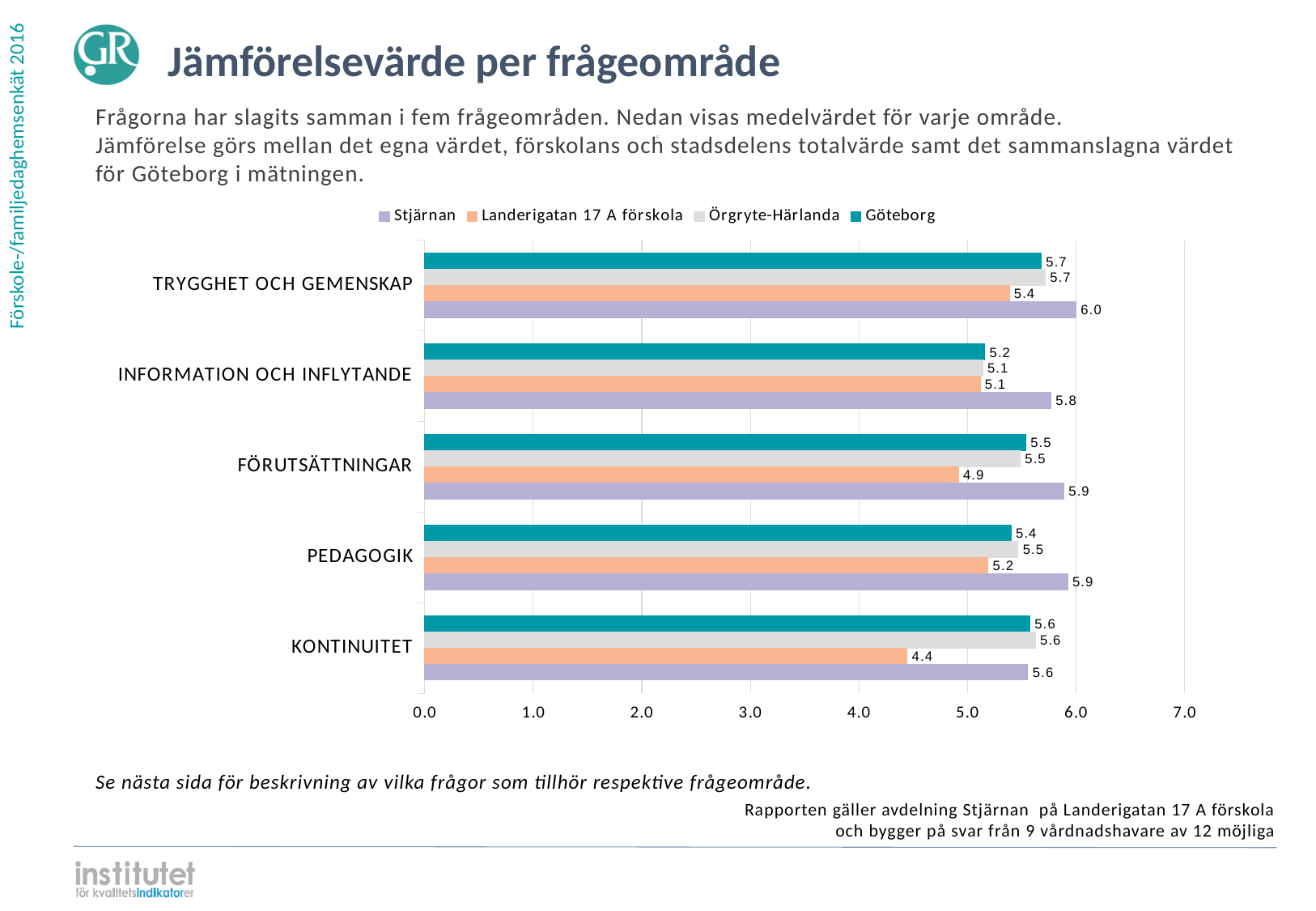
What is the value for Örgryte-Härlanda in the PEDAGOGIK category? 5.5 Which series is shown in teal (dark green-blue) on the chart? Göteborg In which category does Stjärnan have its highest value? TRYGGHET OCH GEMENSKAP How many categories (frågeområden) are shown on the chart? 5 What is the difference between the Stjärnan value and the Landerigatan 17 A förskola value in the FÖRUTSÄTTNINGAR category? 1.0 What is the value for Göteborg in the INFORMATION OCH INFLYTANDE category? 5.2 What kind of chart is shown on the slide? Bar chart In which category does Landerigatan 17 A förskola have its lowest value? KONTINUITET What is the value for Landerigatan 17 A förskola in the KONTINUITET category? 4.4 In the INFORMATION OCH INFLYTANDE category, which is larger: the value for Stjärnan or the value for Göteborg? Stjärnan How many series does the legend list? 4 What is the value for Stjärnan in the TRYGGHET OCH GEMENSKAP category? 6.0